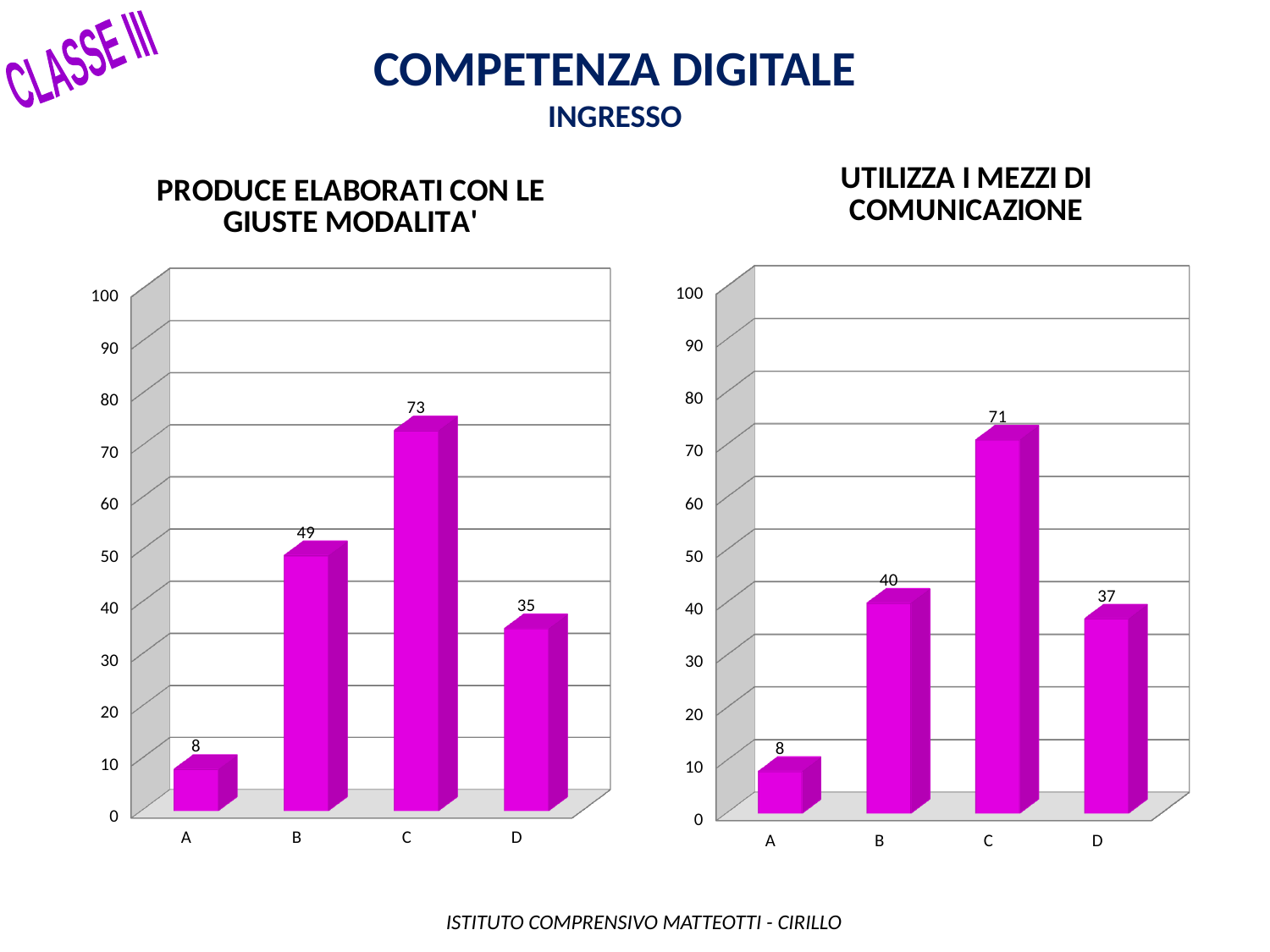
How many categories are shown in the 'UTILIZZA I MEZZI DI COMUNICAZIONE' chart? 4 In the 'UTILIZZA I MEZZI DI COMUNICAZIONE' chart, what is the value for category B? 40 In the 'PRODUCE ELABORATI CON LE GIUSTE MODALITA'' chart, which category has the highest value? C In the 'UTILIZZA I MEZZI DI COMUNICAZIONE' chart, which is larger, the value for B or the value for D? B In the 'PRODUCE ELABORATI CON LE GIUSTE MODALITA'' chart, what is the value for category A? 8 What kind of chart is the 'PRODUCE ELABORATI CON LE GIUSTE MODALITA'' chart? Bar chart In the 'PRODUCE ELABORATI CON LE GIUSTE MODALITA'' chart, what is the value for category C? 73 In the 'UTILIZZA I MEZZI DI COMUNICAZIONE' chart, which category has the lowest value? A What colour are the bars in the two charts on the slide? Magenta In the 'UTILIZZA I MEZZI DI COMUNICAZIONE' chart, what is the difference between the values for C and A? 63 In the 'PRODUCE ELABORATI CON LE GIUSTE MODALITA'' chart, is the value for D greater or less than 40? less In the 'PRODUCE ELABORATI CON LE GIUSTE MODALITA'' chart, what is the difference between the values for B and D? 14